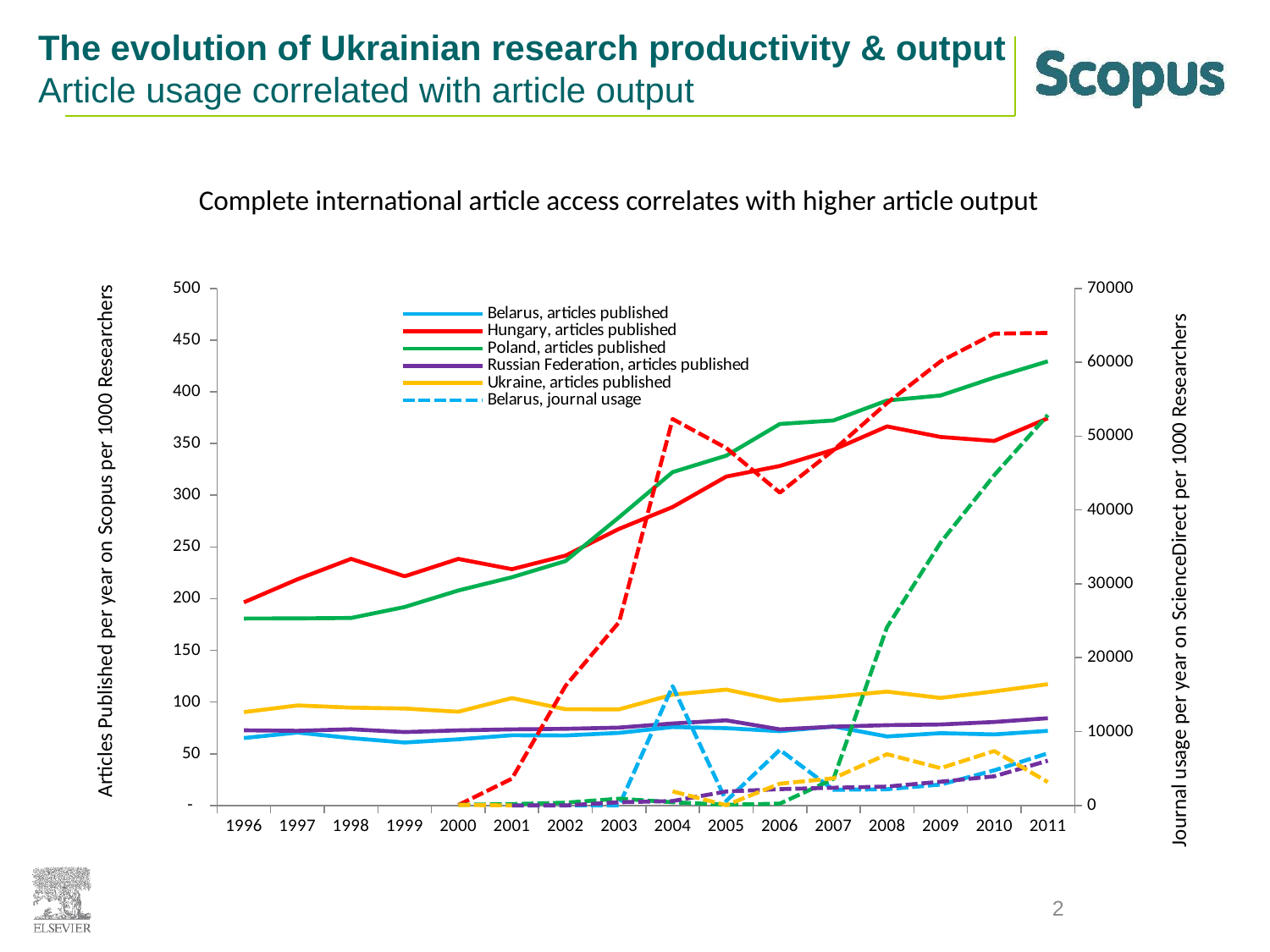
In 1996, which is higher: Hungary, articles published or Poland, articles published? Hungary, articles published Does the Poland, articles published line rise or fall from 1996 to 2011? rise How many years are shown along the x axis of the chart? 16 Which country has the highest articles published value in 2011? Poland Is the value for Ukraine, articles published in 2011 greater or less than 100? greater How many series does the chart legend list? 6 In 2011, which is higher: Poland, articles published or Hungary, articles published? Poland, articles published Is the value for Hungary, articles published in 2006 greater or less than 300? greater What is the title of the left vertical axis of the chart? Articles Published per year on Scopus per 1000 Researchers Is the value for Hungary, articles published in 1996 greater or less than 150? greater What type of chart is shown on the slide? line chart